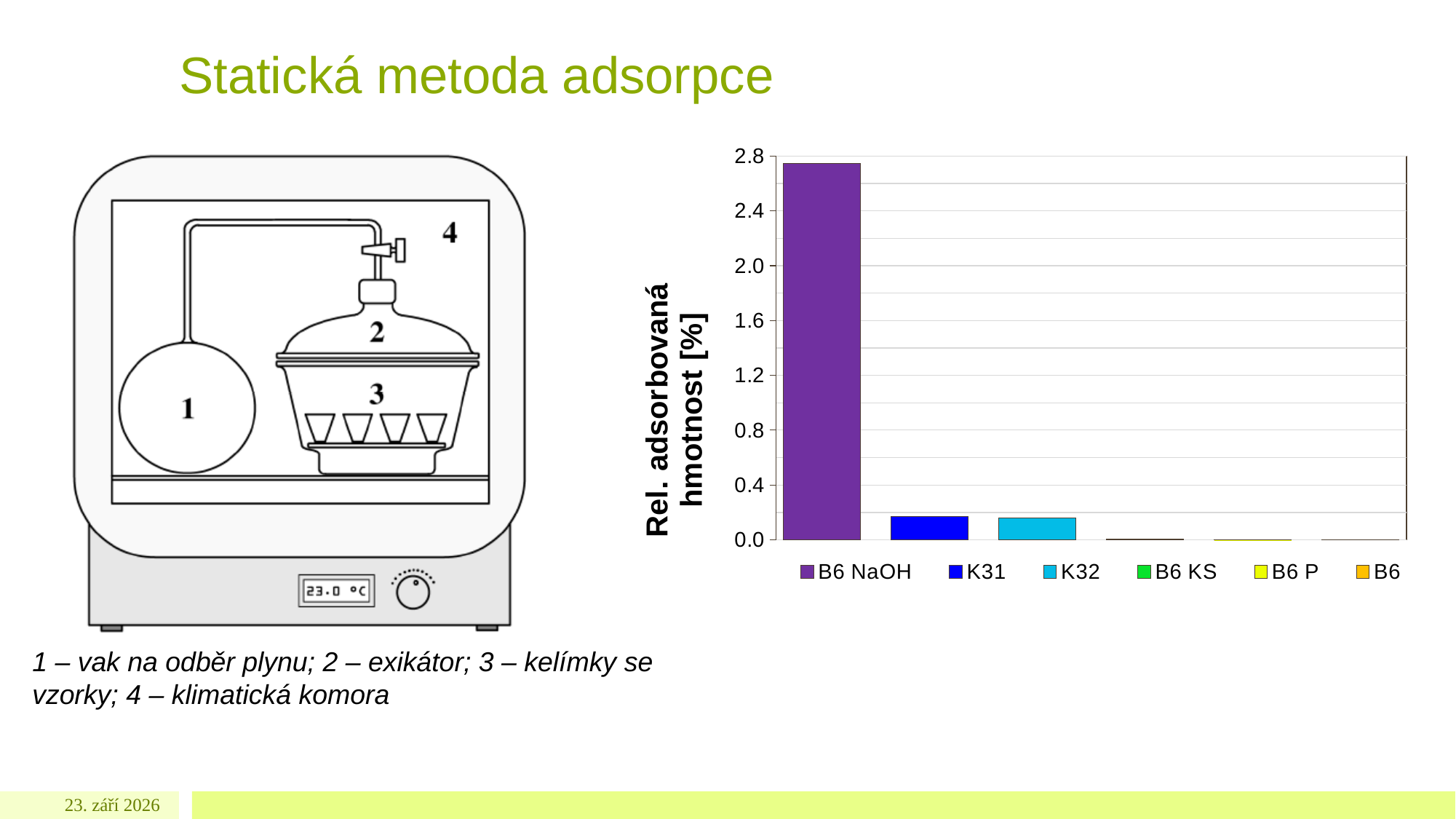
Which is larger, the value for B6 NaOH or the value for K31? B6 NaOH What kind of chart is shown on the slide? bar chart What is the highest value shown on the vertical axis of the chart? 2.8 Is the value for K31 greater or less than 0.4? less Which is larger, the value for K32 or the value for B6 KS? K32 Is the value for B6 NaOH greater or less than 2.4? greater How many series does the chart legend list? 6 Is the value for B6 NaOH greater or less than 2.0? greater What colour is the bar for B6 NaOH in the chart? purple Which series has the highest relative adsorbed mass in the chart? B6 NaOH What is the label of the vertical axis of the chart? Rel. adsorbovaná hmotnost [%]